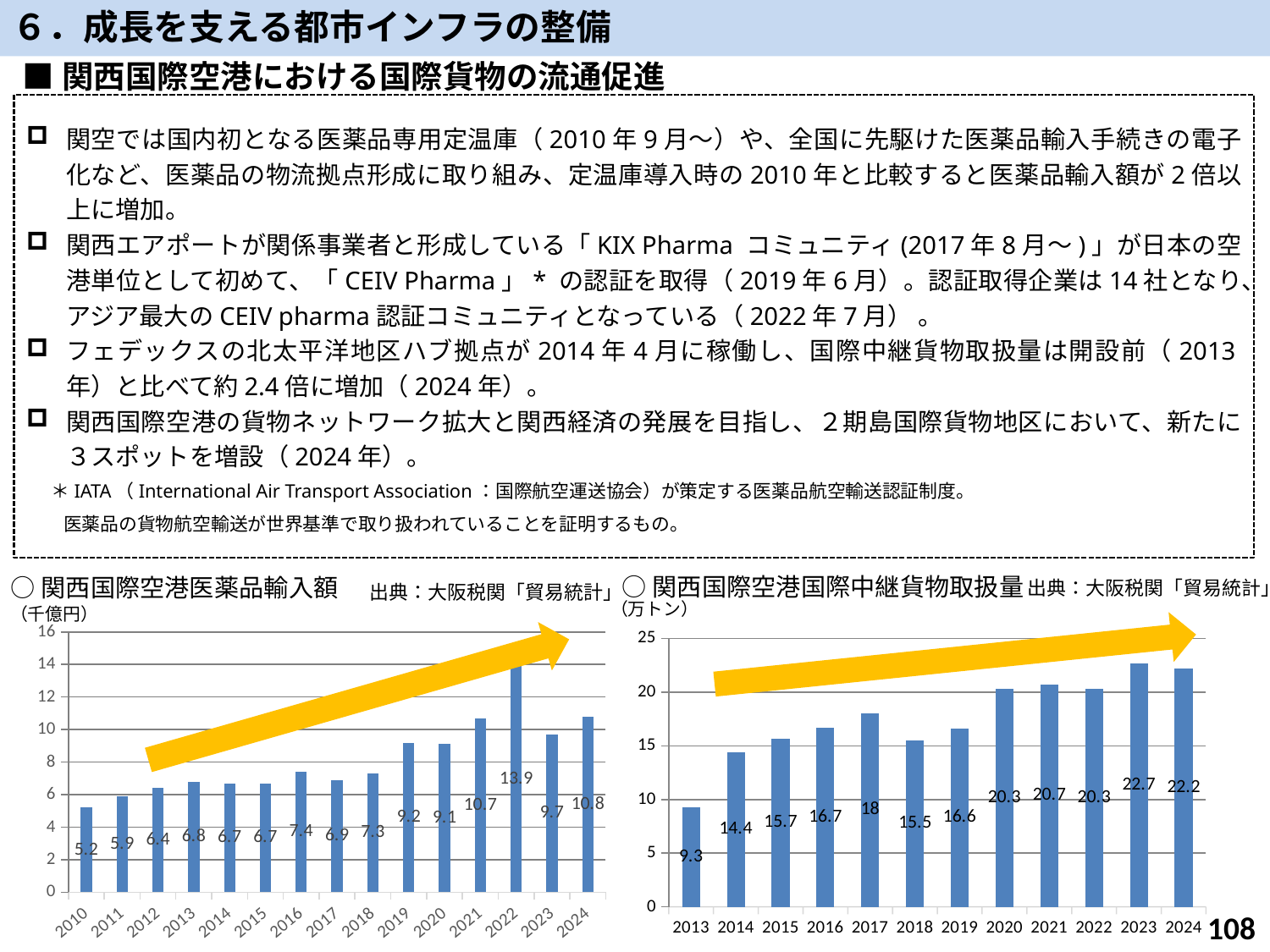
「関西国際空港医薬品輸入額」のグラフで、最も値が高い年はどれですか？ 2022 「関西国際空港国際中継貨物取扱量」のグラフはどの種類のグラフですか？ 棒グラフ 「関西国際空港国際中継貨物取扱量」のグラフで、2017年と2018年ではどちらの値が大きいですか？ 2017 「関西国際空港国際中継貨物取扱量」のグラフで、2013年の値はいくらですか？ 9.3 「関西国際空港医薬品輸入額」のグラフで、2022年の値はいくらですか？ 13.9 「関西国際空港医薬品輸入額」のグラフには何年分のデータがありますか？ 15 「関西国際空港国際中継貨物取扱量」のグラフの縦軸の単位は何ですか？ 万トン 「関西国際空港国際中継貨物取扱量」のグラフで、最も値が高い年はどれですか？ 2023 「関西国際空港国際中継貨物取扱量」のグラフで、2024年と2013年の値の差はいくらですか？ 12.9 「関西国際空港医薬品輸入額」のグラフで、2024年と2023年の値の差はいくらですか？ 1.1 「関西国際空港医薬品輸入額」のグラフで、2010年の値はいくらですか？ 5.2 「関西国際空港医薬品輸入額」のグラフで、最も値が低い年はどれですか？ 2010